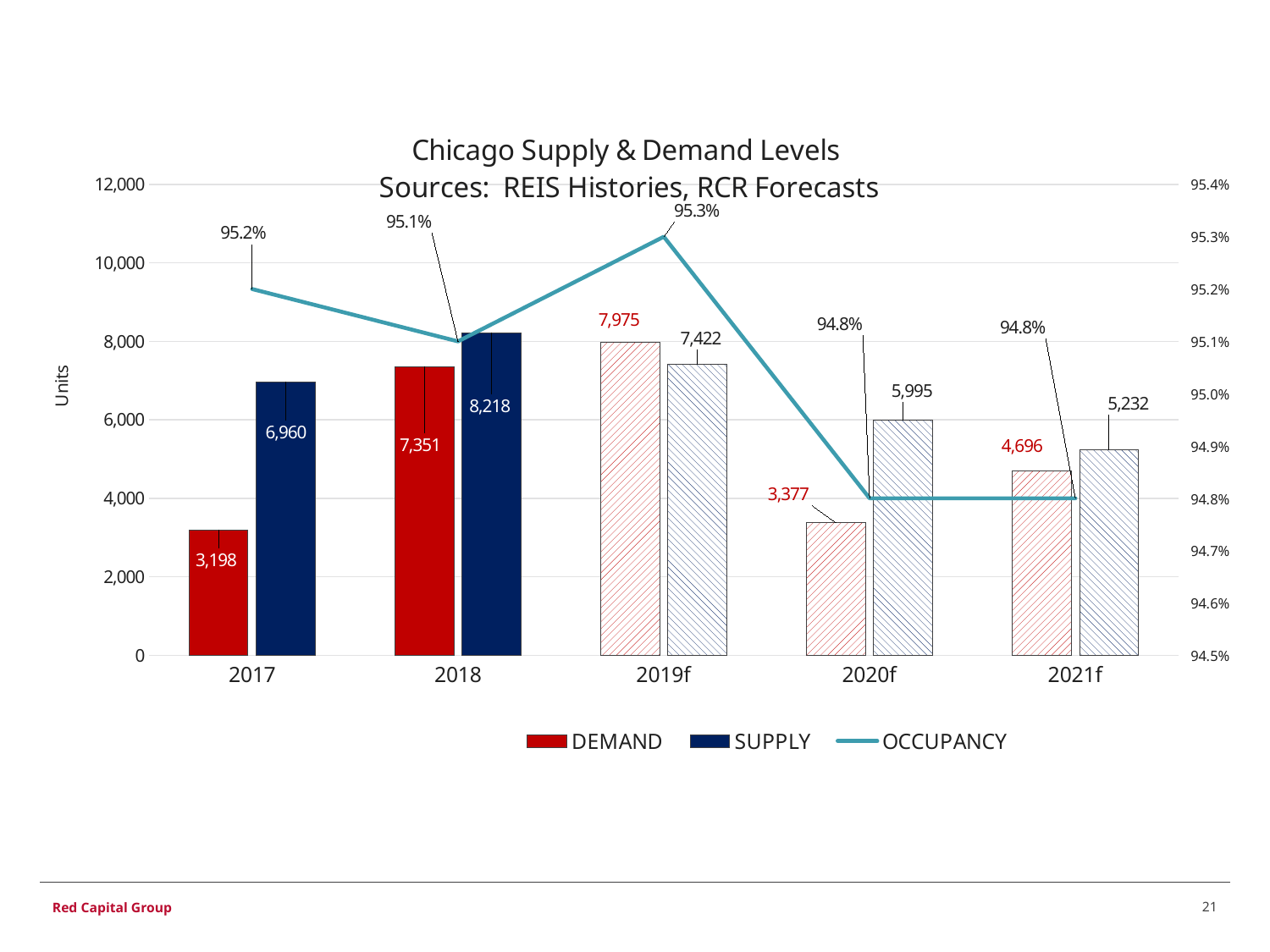
What is the SUPPLY value for 2021f? 5,232 How many years are shown on the x axis? 5 Which is larger in 2019f, DEMAND or SUPPLY? DEMAND Which year has the lowest SUPPLY value? 2021f Which year has the highest DEMAND value? 2019f What is the SUPPLY value for 2018? 8,218 What is the OCCUPANCY value for 2019f? 95.3% What is the DEMAND value for 2017? 3,198 Is the DEMAND value for 2020f greater or less than 4,000? less How many series does the legend list? 3 What is the title of the chart? Chicago Supply & Demand Levels Sources: REIS Histories, RCR Forecasts What is the difference between SUPPLY and DEMAND in 2017? 3,762